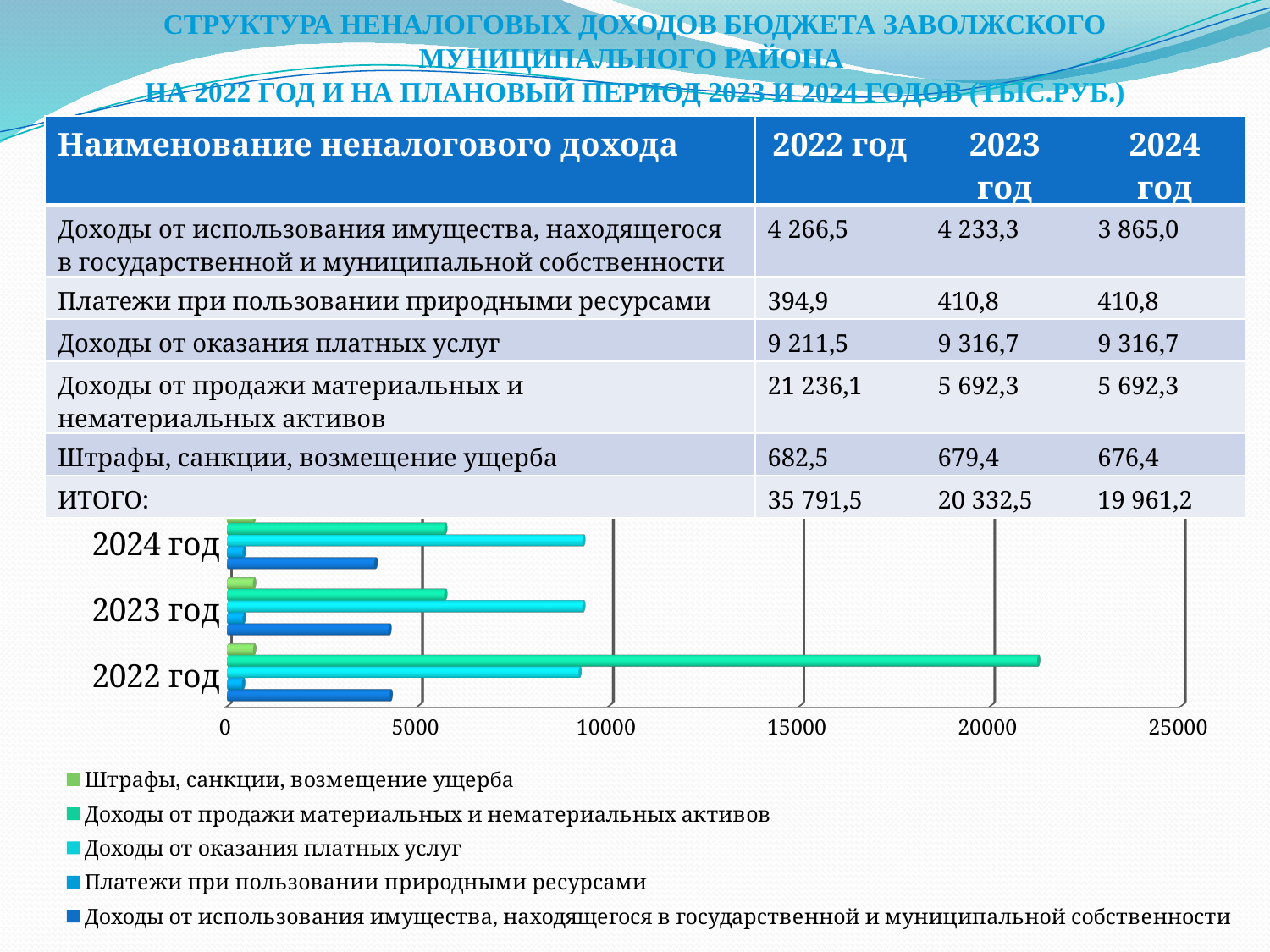
Which series is listed first in the chart legend? Штрафы, санкции, возмещение ущерба In 2022, which bar is longer: 'Доходы от оказания платных услуг' or 'Доходы от использования имущества, находящегося в государственной и муниципальной собственности'? Доходы от оказания платных услуг How many year categories are shown on the chart's vertical axis? 3 According to the table, what is the ИТОГО value for 2024 год? 19 961,2 In which year is the bar for 'Доходы от продажи материальных и нематериальных активов' the longest? 2022 год On the chart, is the bar for 'Доходы от оказания платных услуг' in 2023 greater or less than 10000? less Do the values for 'Доходы от использования имущества, находящегося в государственной и муниципальной собственности' rise or fall from 2022 to 2024? fall What kind of chart is shown below the table? bar chart How many series does the chart legend list? 5 Using the table values, what is the difference between 'Доходы от продажи материальных и нематериальных активов' in 2022 and in 2023? 15 543,8 On the chart, is the bar for 'Доходы от продажи материальных и нематериальных активов' in 2022 greater or less than 20000? greater According to the table, what is the value of 'Доходы от продажи материальных и нематериальных активов' for 2022 год? 21 236,1